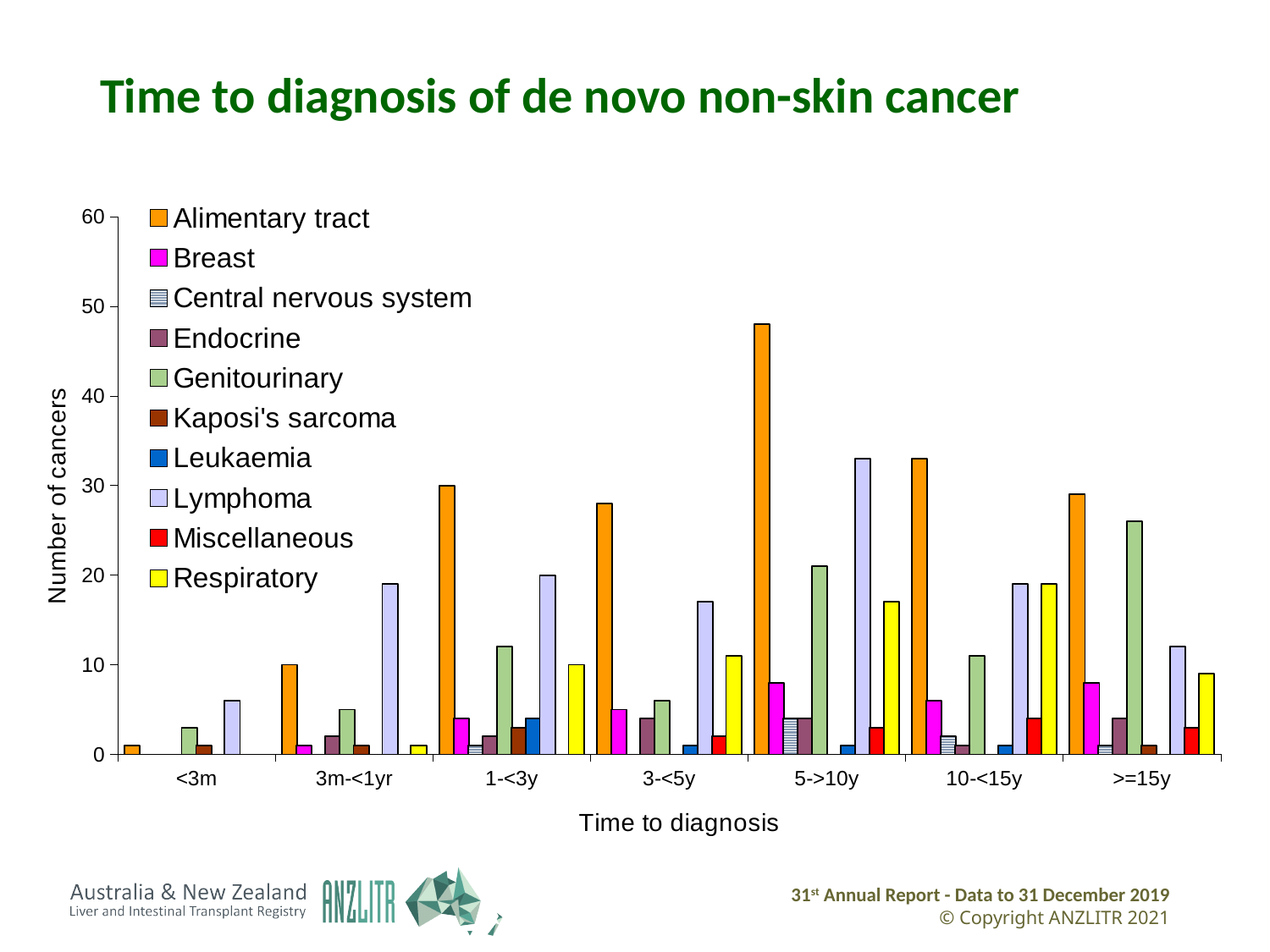
In which time-to-diagnosis category is the Alimentary tract bar highest? 5->10y Is the value for Lymphoma in the 5->10y category greater or less than 30? greater How many time-to-diagnosis categories are shown on the x axis? 7 What kind of chart is shown on the slide? bar chart How many series does the legend list? 10 Which series has the tallest bar anywhere on the chart? Alimentary tract In the >=15y category, which is larger: Genitourinary or Lymphoma? Genitourinary Is the value for Genitourinary in the >=15y category greater or less than 20? greater Is the value for Alimentary tract in the 5->10y category greater or less than 40? greater In the 5->10y category, which is larger: Alimentary tract or Lymphoma? Alimentary tract What is the title of the y axis? Number of cancers